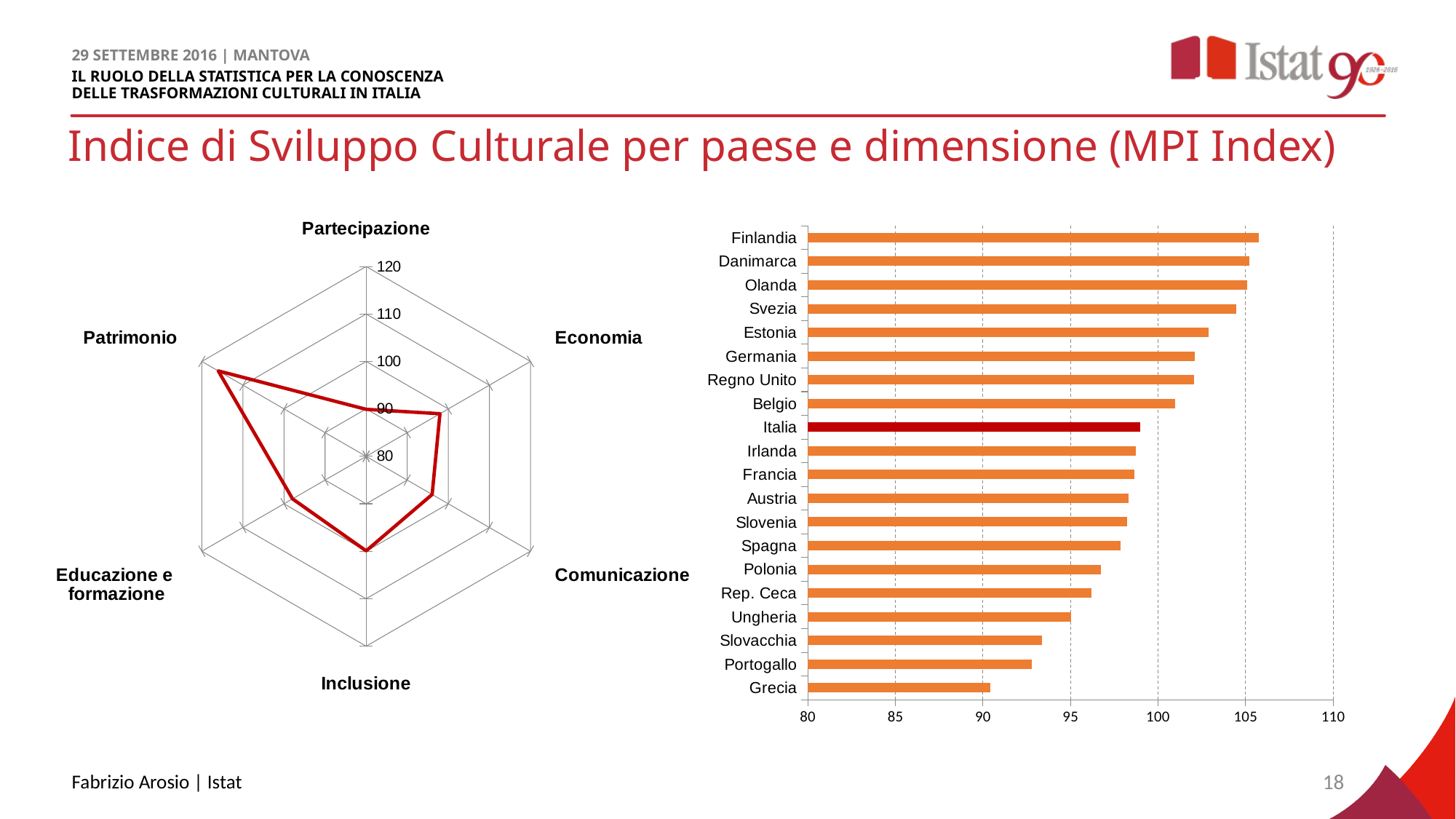
On the bar chart on the right, is the value for Slovacchia greater or less than 95? less What kind of chart is the chart on the left of the slide? Radar chart On the bar chart on the right, which country's bar is drawn in a different (dark red) colour from the others? Italia What kind of chart is the chart on the right of the slide? Bar chart How many countries are shown on the bar chart on the right? 20 On the radar chart on the left, is the value for Patrimonio greater or less than 110? greater On the bar chart on the right, which country has the highest value? Finlandia On the bar chart on the right, is the value for Finlandia greater or less than 105? greater On the bar chart on the right, which country has the lowest value? Grecia On the radar chart on the left, which dimension has the highest value? Patrimonio On the bar chart on the right, which has the larger value, Svezia or Estonia? Svezia